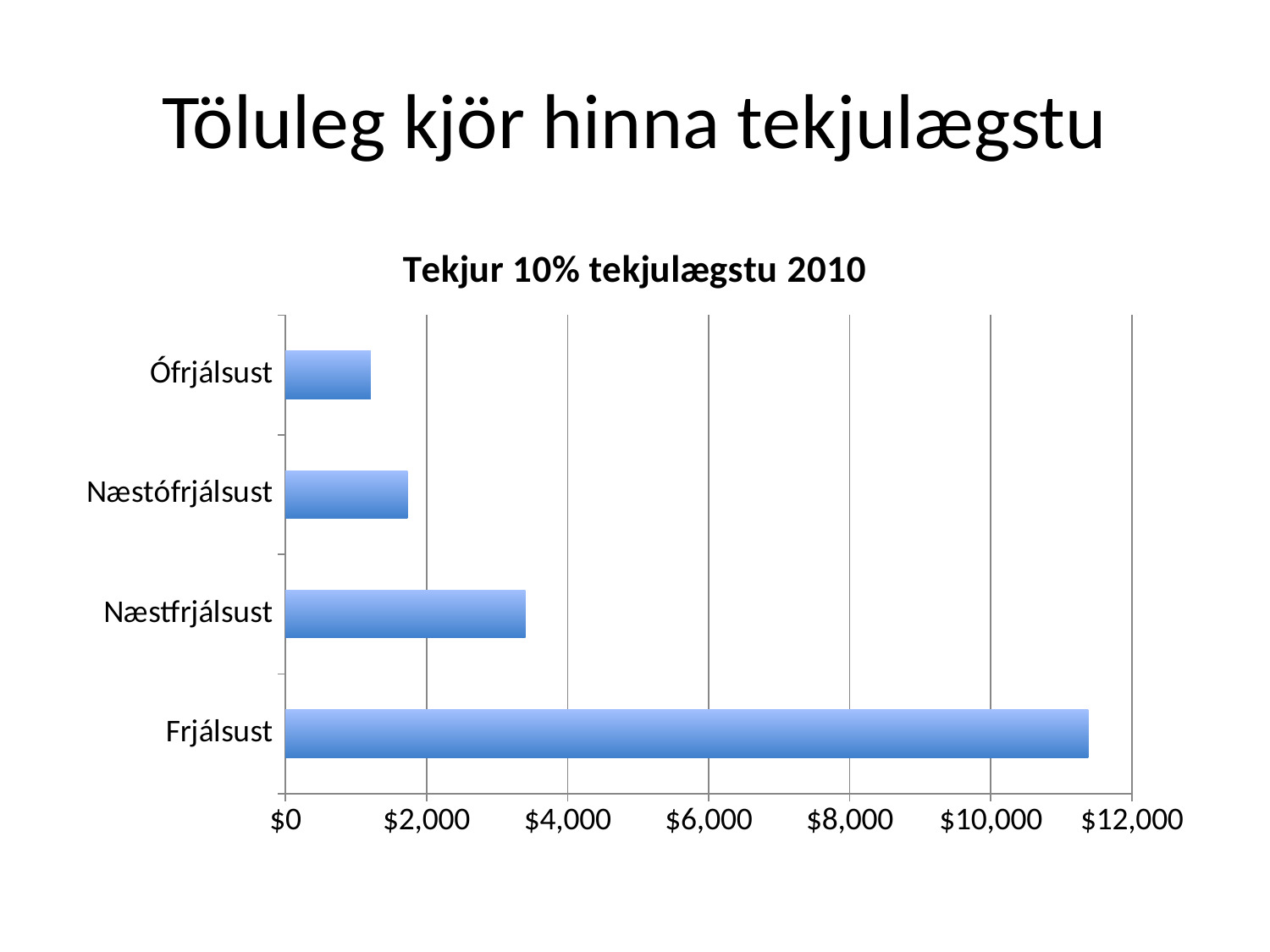
Is the value for Næstófrjálsust greater or less than $2,000? less Which category has the lowest value? Ófrjálsust What is the title of the chart? Tekjur 10% tekjulægstu 2010 What is the maximum value shown on the horizontal axis? $12,000 Which is larger, the value for Frjálsust or the value for Næstfrjálsust? Frjálsust How many categories are shown in the chart? 4 Is the value for Ófrjálsust greater or less than $2,000? less Is the value for Frjálsust greater or less than $10,000? greater Which category has the highest value? Frjálsust Which is larger, the value for Næstfrjálsust or the value for Næstófrjálsust? Næstfrjálsust What kind of chart is shown on the slide? bar chart